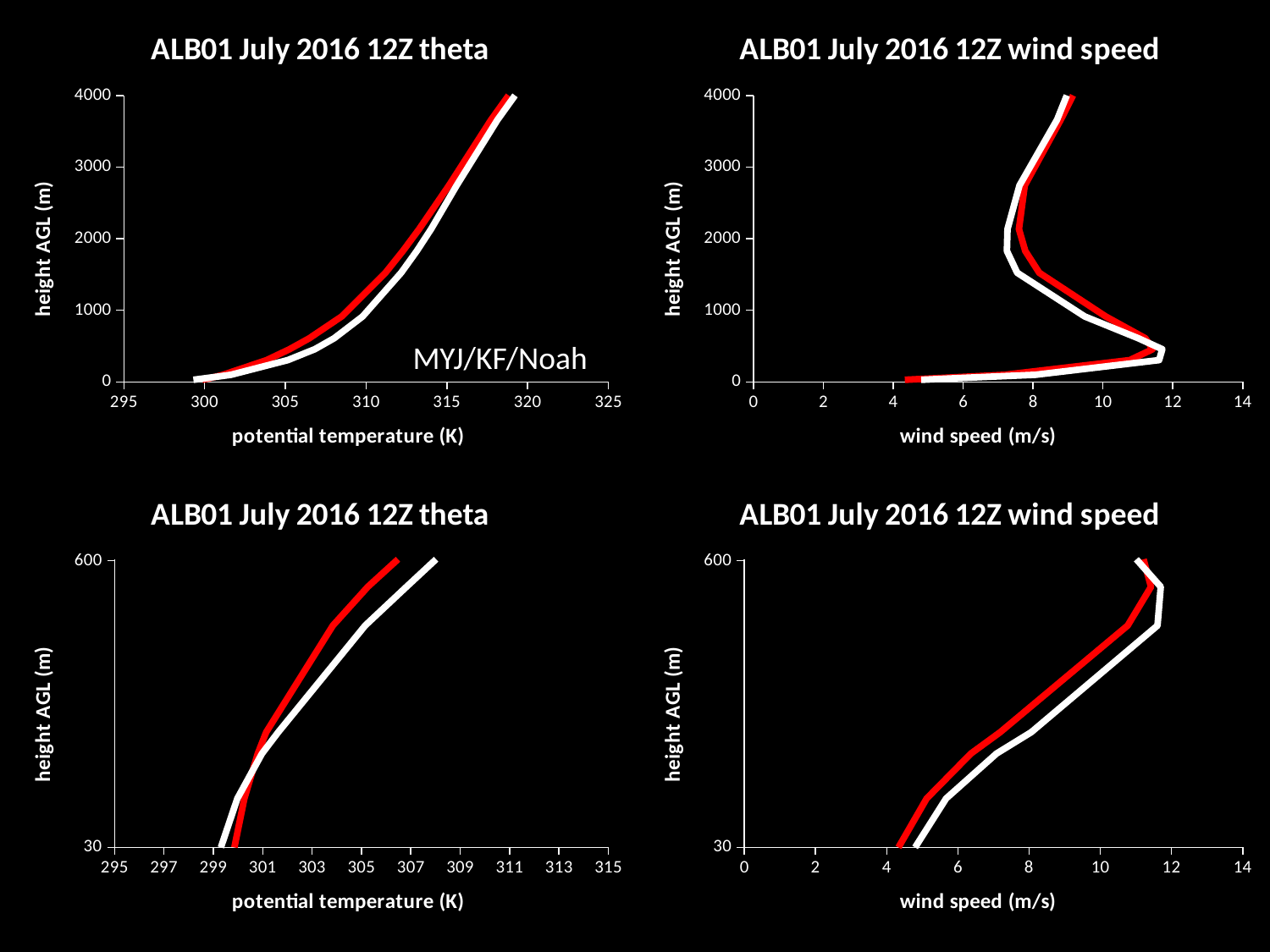
In the bottom-right chart "ALB01 July 2016 12Z wind speed", does wind speed increase or decrease as height increases from 30 m to 600 m? increase In the top-right chart "ALB01 July 2016 12Z wind speed", is the wind speed at a height of 0 m greater or less than 6 m/s? less In the top-left chart "ALB01 July 2016 12Z theta", is the potential temperature at 0 m greater or less than 305 K? less How many charts are shown on the slide? 4 What kind of chart is the top-left chart titled "ALB01 July 2016 12Z theta"? line chart In the top-right chart "ALB01 July 2016 12Z wind speed", is the maximum wind speed reached near 500 m greater or less than 10 m/s? greater What is the x-axis label of the top-right chart "ALB01 July 2016 12Z wind speed"? wind speed (m/s) In the bottom-left chart "ALB01 July 2016 12Z theta", does potential temperature increase or decrease as height increases from 30 m to 600 m? increase What text annotation appears inside the plot area of the top-left chart "ALB01 July 2016 12Z theta"? MYJ/KF/Noah